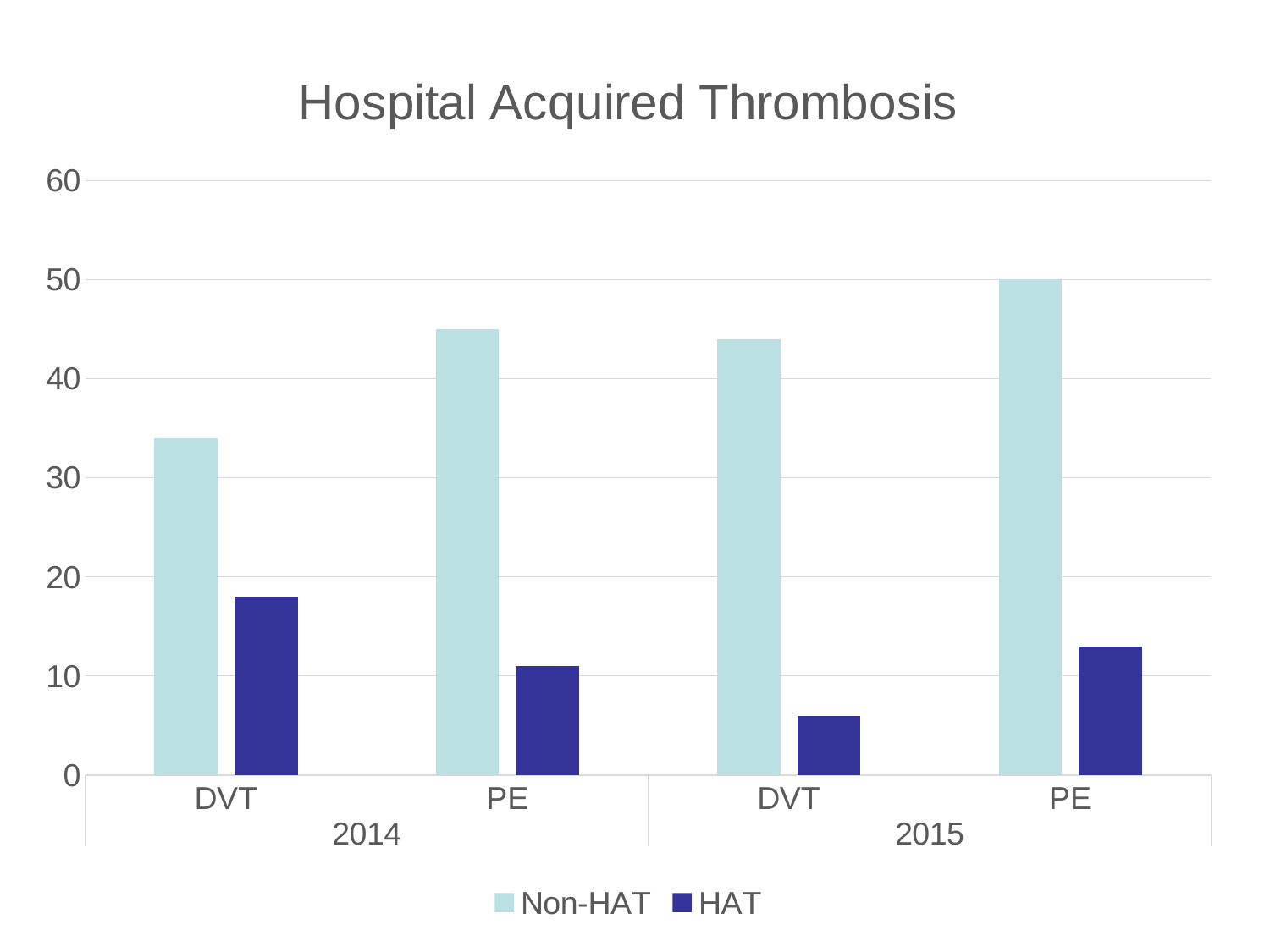
Which category has the highest HAT value? DVT in 2014 Which category has the lowest Non-HAT value? DVT in 2014 Is the HAT value for DVT in 2014 larger or smaller than the HAT value for DVT in 2015? larger Is the HAT value for DVT in 2015 greater or less than 10? less Which category has the lowest HAT value? DVT in 2015 What is the Non-HAT value for PE in 2015? 50 How many series does the legend list? 2 Which category has the highest Non-HAT value? PE in 2015 What is the title of the chart? Hospital Acquired Thrombosis Is the Non-HAT value for DVT in 2014 greater or less than 30? greater What kind of chart is shown on the slide? bar chart How many category groups are shown along the x axis? 4